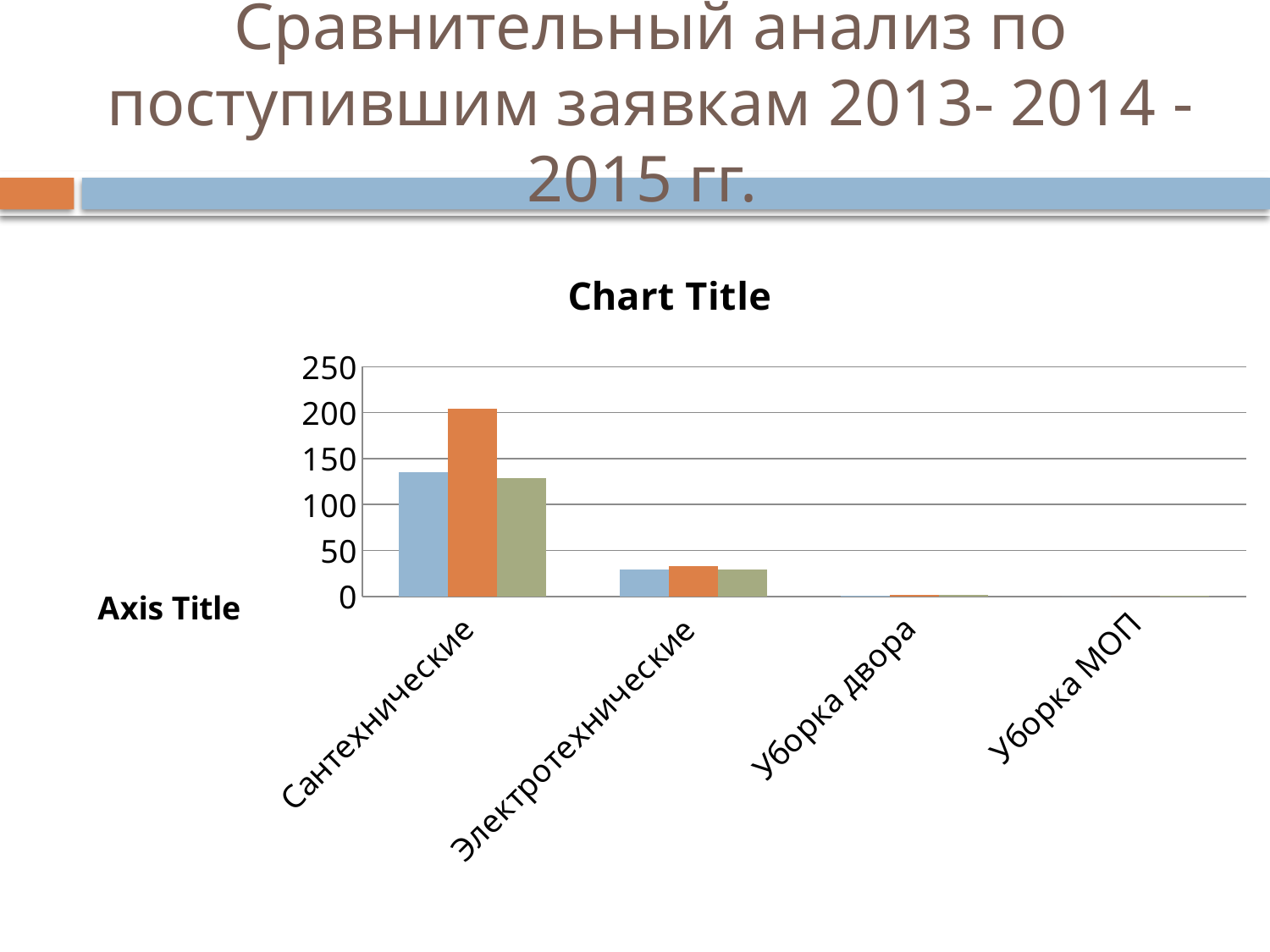
Do the bar values generally rise or fall moving from left to right along the x axis? fall How many bars are plotted for each category in the chart? 3 Is the value of the blue bar for Электротехнические greater or less than 50? less Which category has the larger orange bar: Сантехнические or Электротехнические? Сантехнические Is the value of the orange bar for Сантехнические greater or less than 150? greater What kind of chart is shown on the slide? bar chart Which category has the tallest bars in the chart? Сантехнические For Сантехнические, which bar is taller: the orange bar or the blue bar? the orange bar How many categories are shown on the x axis of the chart? 4 Is the value of the blue bar for Сантехнические greater or less than 100? greater What is the title printed above the chart? Chart Title